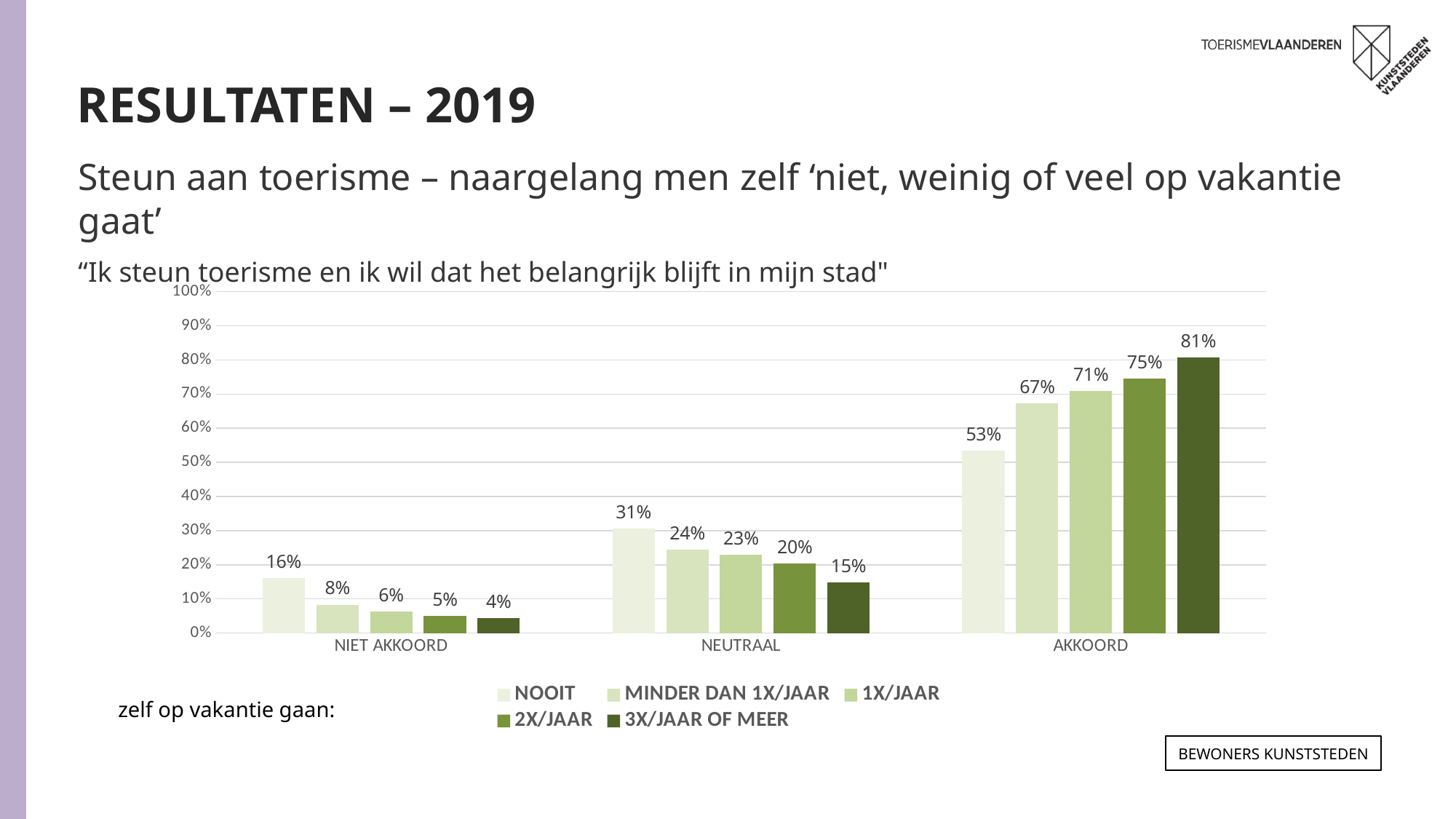
What is the value for MINDER DAN 1X/JAAR in the NEUTRAAL category? 24% What is the difference between the 3X/JAAR OF MEER and NOOIT values in the AKKOORD category? 28% What is the value for NOOIT in the AKKOORD category? 53% Within the AKKOORD category, do the values rise or fall from NOOIT to 3X/JAAR OF MEER? Rise How many series does the legend list? 5 Which series has the highest value in the AKKOORD category? 3X/JAAR OF MEER Which is larger in the NEUTRAAL category: NOOIT or 1X/JAAR? NOOIT Which series has the lowest value in the NEUTRAAL category? 3X/JAAR OF MEER What kind of chart is shown on the slide? Bar chart What is the value for 2X/JAAR in the NIET AKKOORD category? 5% How many categories are shown on the x axis? 3 What is the value for 3X/JAAR OF MEER in the NIET AKKOORD category? 4%